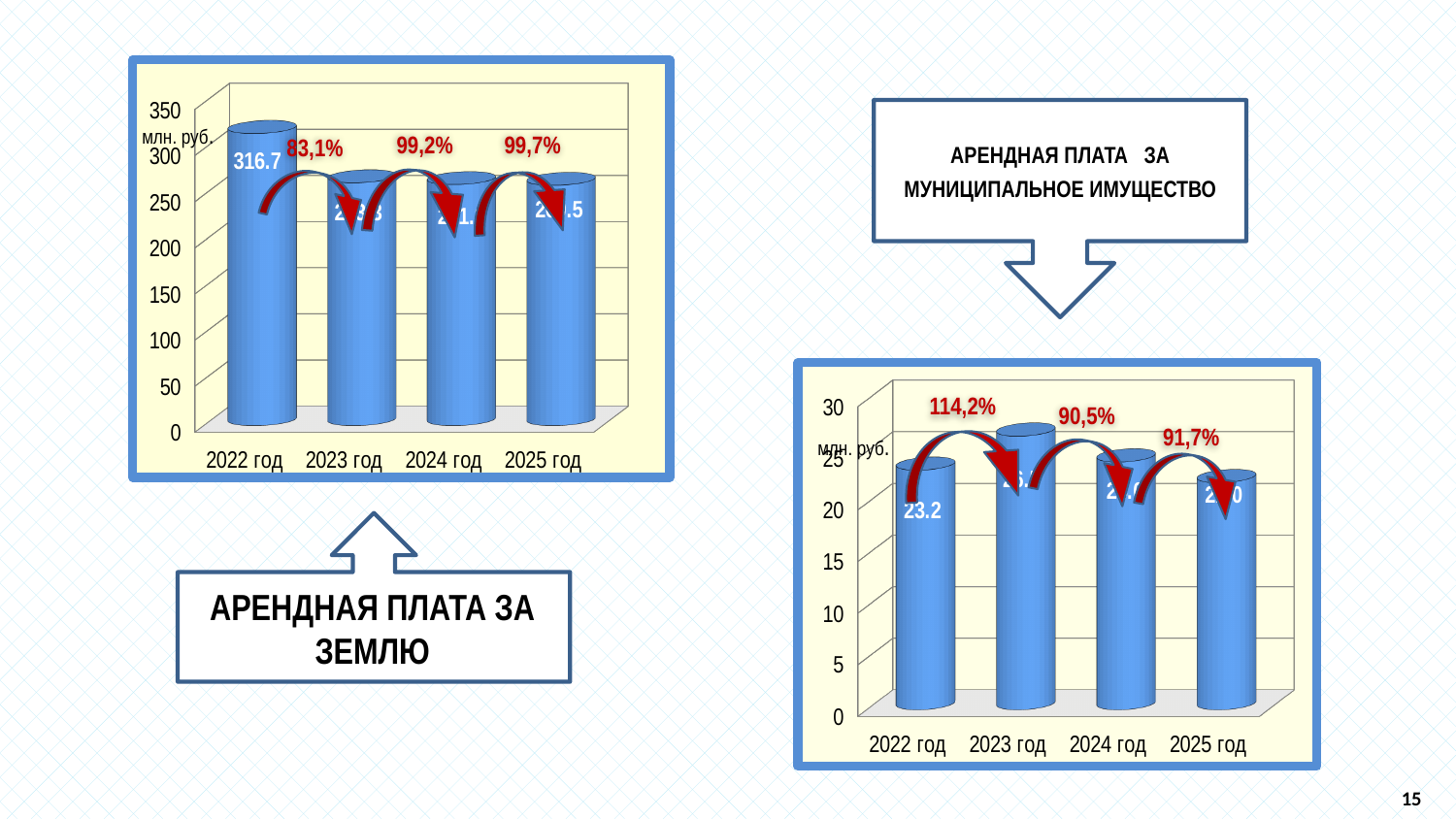
On the left chart ('Арендная плата за землю'), which year has the highest value? 2022 год On the right chart ('Арендная плата за муниципальное имущество'), what percentage is shown above the arrow from 2024 год to 2025 год? 91,7% On the right chart ('Арендная плата за муниципальное имущество'), which year has the highest value? 2023 год On the left chart ('Арендная плата за землю'), is the value for 2023 год greater or less than 300? less On the chart for 'Арендная плата за землю' (left), what is the value for 2022 год? 316.7 What type of chart is used for 'Арендная плата за муниципальное имущество' (right)? Bar chart On the left chart ('Арендная плата за землю'), what percentage is shown above the arrow from 2022 год to 2023 год? 83,1% How many years are shown on the left chart ('Арендная плата за землю')? 4 On the right chart ('Арендная плата за муниципальное имущество'), is the value for 2025 год greater or less than 25? less On the right chart ('Арендная плата за муниципальное имущество'), what percentage is shown above the arrow from 2022 год to 2023 год? 114,2% On the right chart ('Арендная плата за муниципальное имущество'), which is larger: the value for 2022 год or 2023 год? 2023 год On the chart for 'Арендная плата за муниципальное имущество' (right), what is the value for 2022 год? 23.2